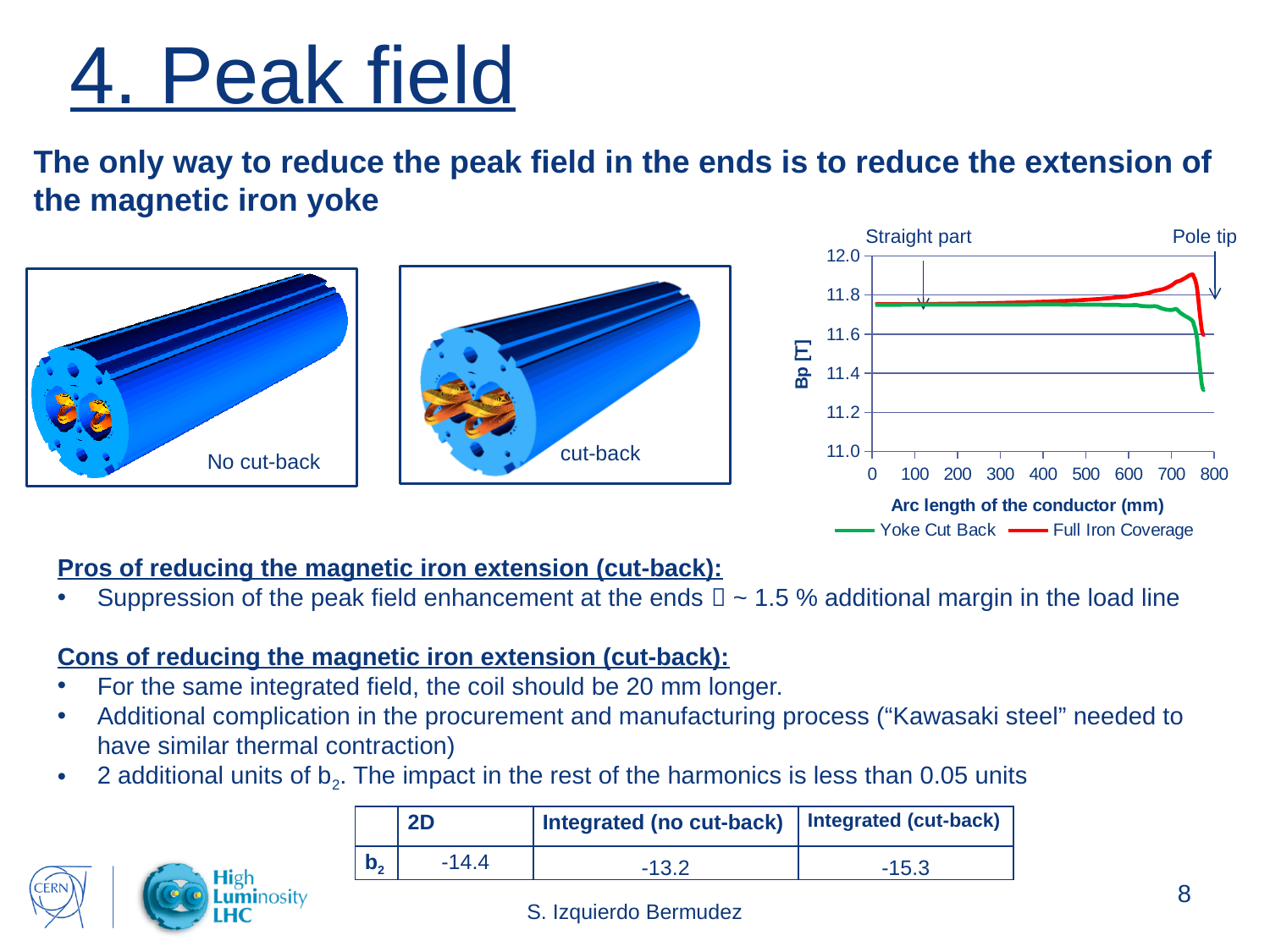
Near an arc length of 750 mm, which series has the higher value: Yoke Cut Back or Full Iron Coverage? Full Iron Coverage Does the Yoke Cut Back series rise or fall as the arc length approaches the pole tip (beyond 700 mm)? fall Is the lowest value of the Yoke Cut Back series greater or less than 11.4? less What is the label of the chart's x axis? Arc length of the conductor (mm) What are the two series named in the chart legend? Yoke Cut Back and Full Iron Coverage Is the value of the Yoke Cut Back series at an arc length of 400 mm greater or less than 11.6? greater Does the Full Iron Coverage series rise or fall between 0 mm and about 750 mm of arc length? rise Which series reaches the higher peak value of Bp? Full Iron Coverage Is the peak value of the Full Iron Coverage series greater or less than 11.8? greater Which series drops to the lower value of Bp at the end of the conductor (near 800 mm)? Yoke Cut Back What kind of chart is shown on the slide? line chart How many series does the chart legend list? 2